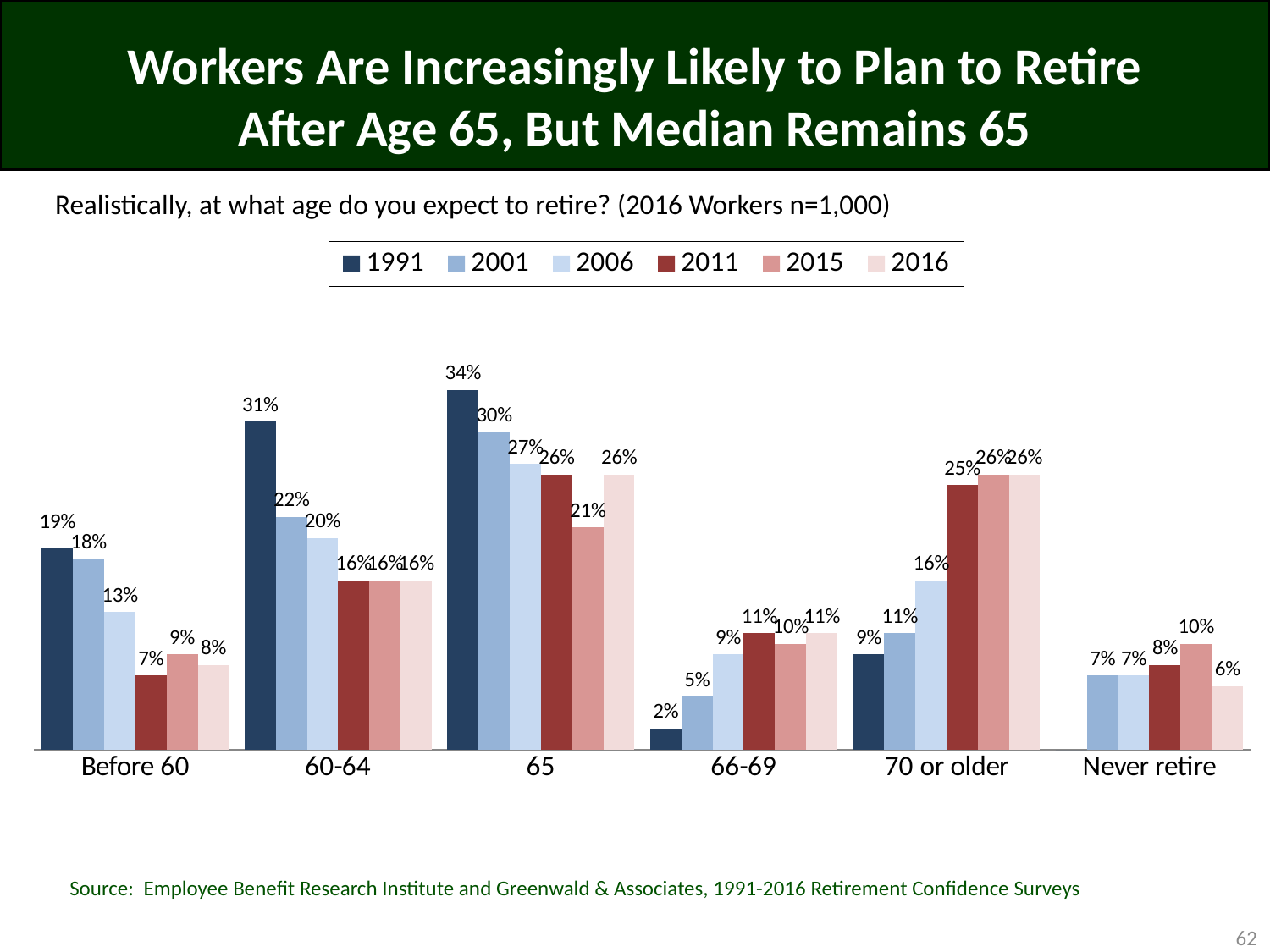
How many retirement age categories are shown on the x axis? 6 What percentage of workers in 1991 expected to retire at age 65? 34% What percentage of workers in 2006 expected to retire before age 60? 13% What is the 2016 value for the '70 or older' category? 26% For the '70 or older' category, which is larger: the 1991 value or the 2011 value? 2011 Which retirement age category has the highest value for the 1991 series? 65 What type of chart is shown on the slide? Bar chart Which category has the lowest value for the 1991 series? 66-69 What is the difference between the 1991 and 2016 values for the '60-64' category? 15 percentage points What is the 2015 value for 'Never retire'? 10% For the '70 or older' category, do the values rise or fall from 1991 to 2016? Rise How many series does the legend list? 6